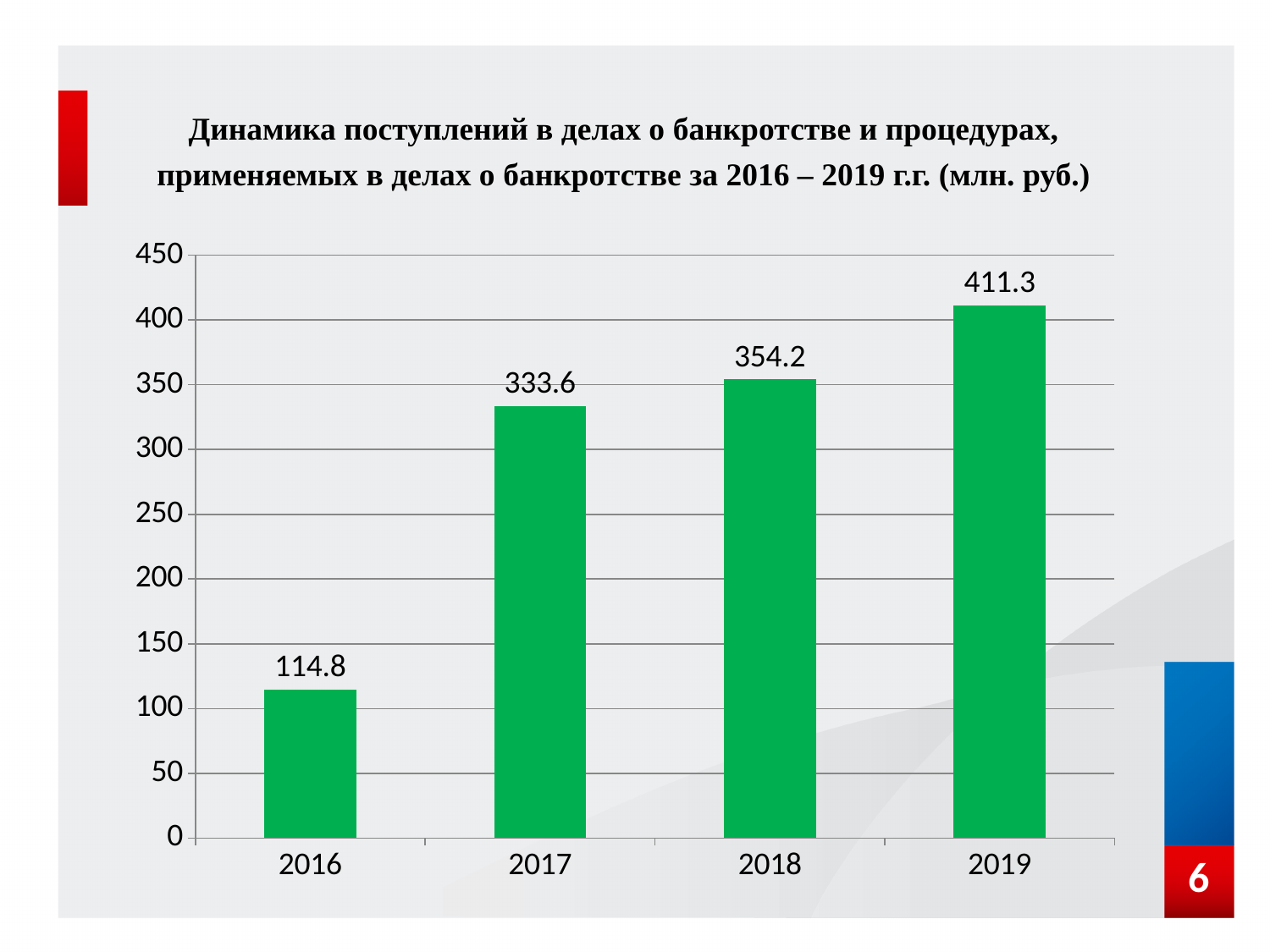
Is the value for 2019 greater or less than 400? greater What is the value for 2016? 114.8 Which year has the lowest value? 2016 What kind of chart is shown on the slide? bar chart How many years are shown on the chart? 4 Which is larger, the value for 2017 or the value for 2018? 2018 What is the value for 2017? 333.6 What is the value for 2018? 354.2 What is the difference between the values for 2018 and 2017? 20.6 What is the value for 2019? 411.3 Which year has the highest value? 2019 What is the difference between the values for 2019 and 2016? 296.5